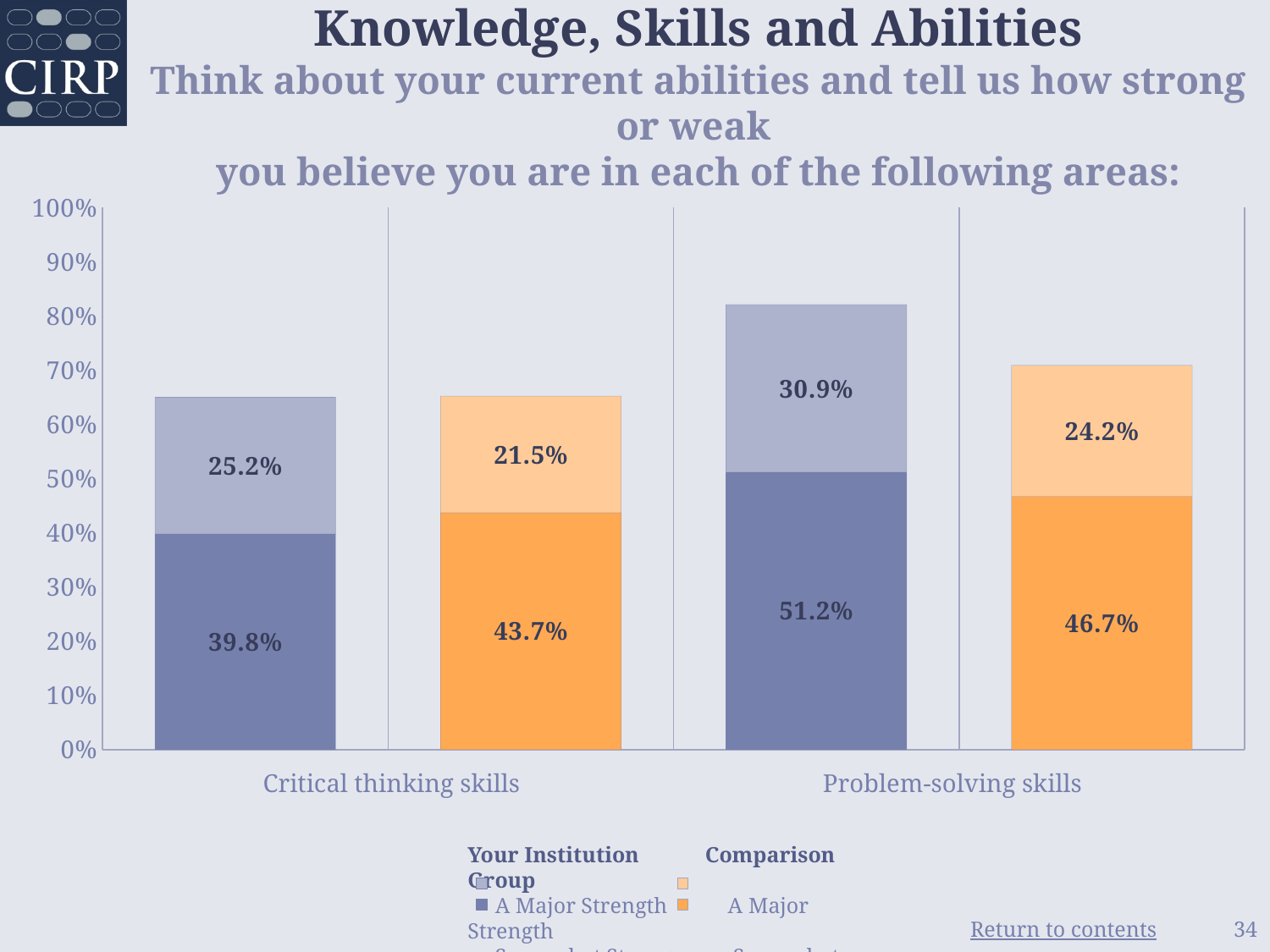
How many skill categories are shown on the x axis? 2 What is the total height of the Your Institution stacked bar for problem-solving skills? 82.1% What percentage of the Comparison Group rated problem-solving skills as a major strength? 46.7% What is the total height of the Comparison Group stacked bar for problem-solving skills? 70.9% For critical thinking skills, which group has the larger 'A Major Strength' value, Your Institution or the Comparison Group? Comparison Group What is the value of the lighter upper segment of the Comparison Group bar for critical thinking skills? 21.5% Which 'A Major Strength' value is the lowest on the chart? Your Institution, Critical thinking skills (39.8%) What is the value of the lighter upper segment of the Your Institution bar for problem-solving skills? 30.9% What percentage of Your Institution students rated critical thinking skills as a major strength? 39.8% What is the difference between the Your Institution and Comparison Group 'A Major Strength' values for problem-solving skills? 4.5 percentage points Which 'A Major Strength' value is the highest on the chart? Your Institution, Problem-solving skills (51.2%) What type of chart is shown on the slide? Stacked bar chart